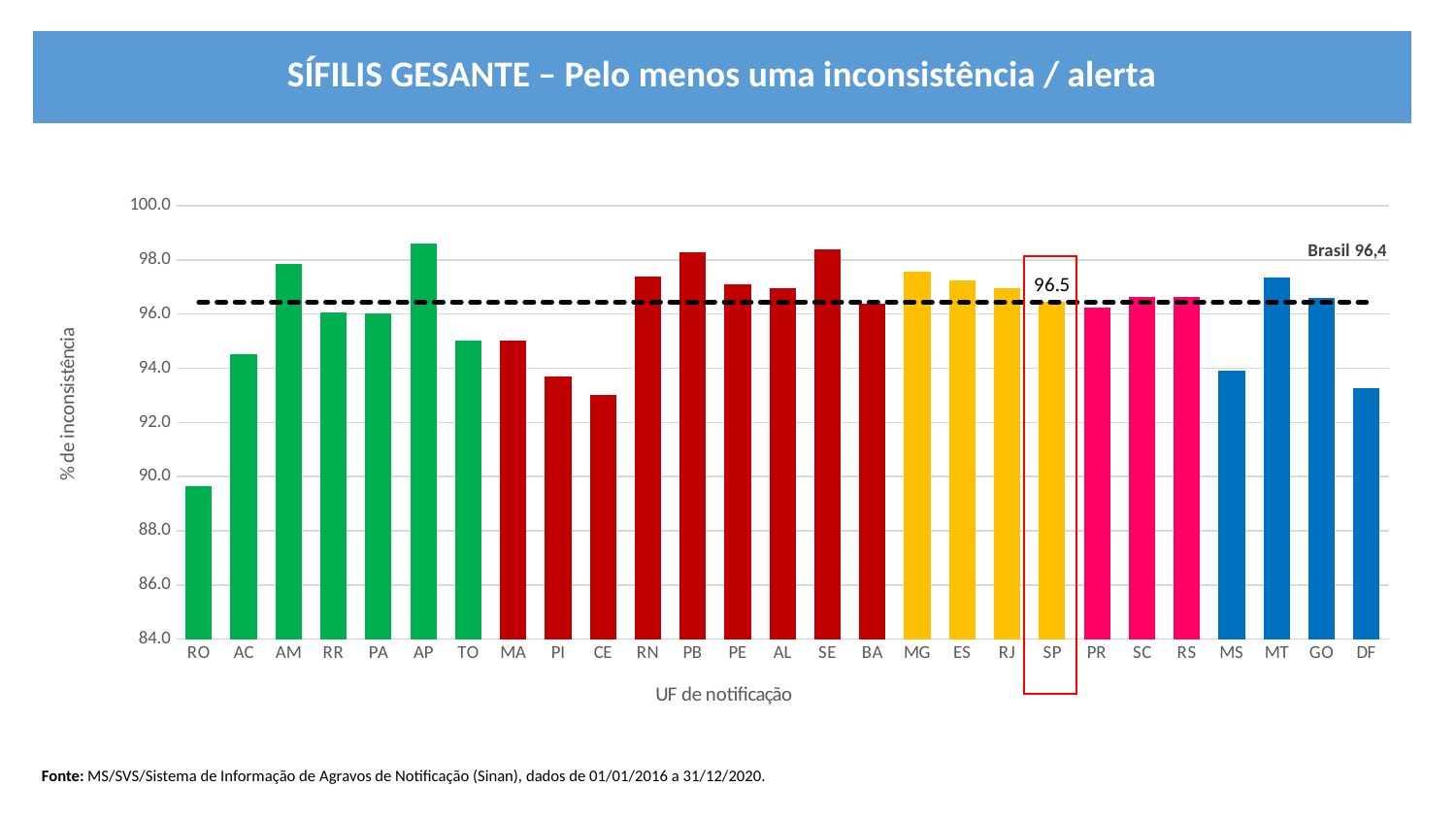
Is the value for RO greater or less than 90.0? less How many UFs are shown on the x axis? 27 What value is shown for Brasil by the dashed reference line? 96,4 What kind of chart is shown on the slide? bar chart Is the value for CE greater or less than 92.0? greater Which has a higher value, RO or AC? AC Which has a higher value, PB or PE? PB What value is labelled on the bar for SP? 96.5 What is the title of the x axis? UF de notificação Which UF has the lowest % de inconsistência? RO Is the value for DF greater or less than 94.0? less